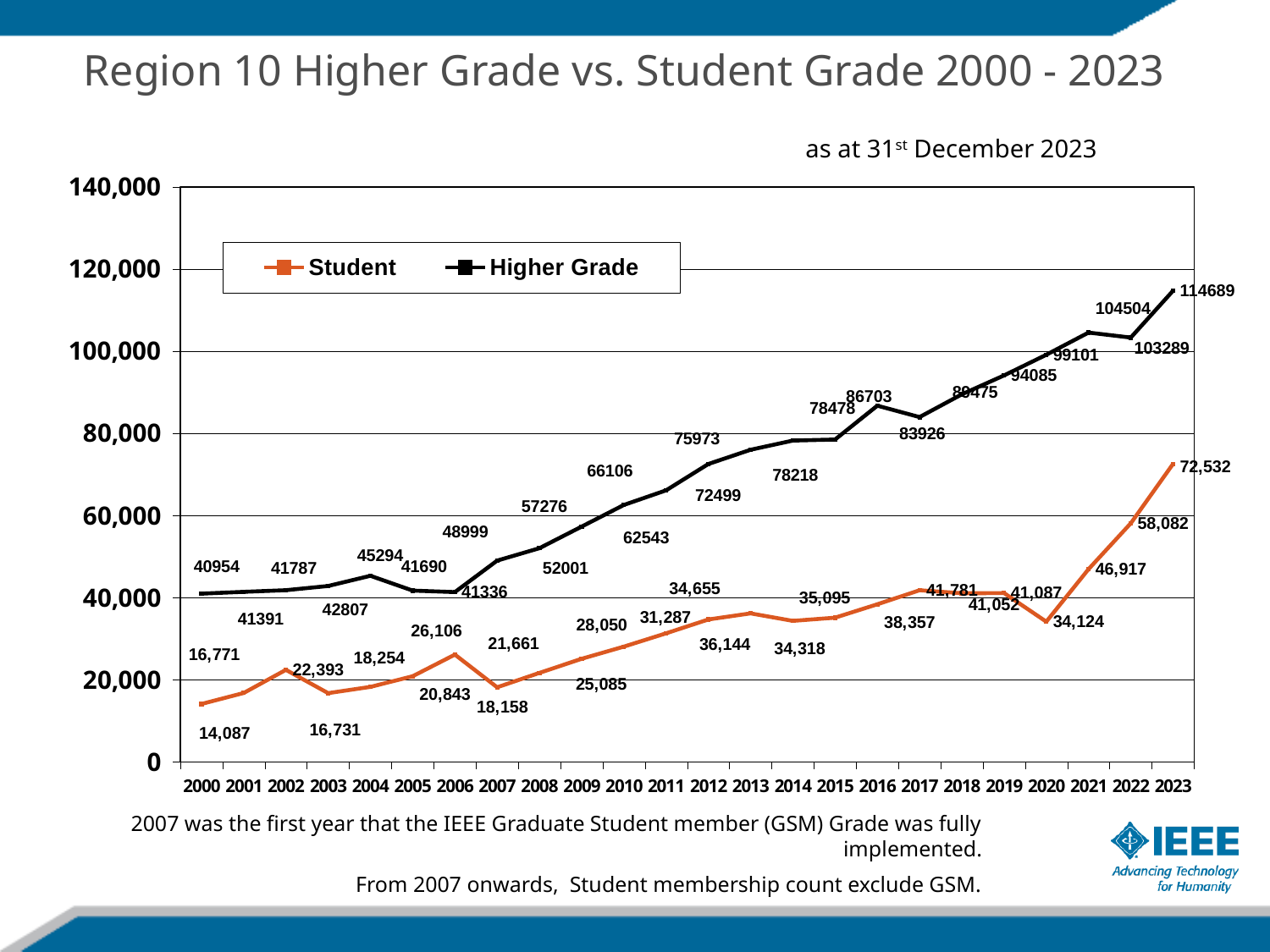
What is the Higher Grade value for 2023? 114689 What is the Student value for 2000? 14,087 What is the Student value for 2023? 72,532 What kind of chart is shown on the slide? line chart Which year has the larger Higher Grade value, 2016 or 2017? 2016 In which year is the Student series at its highest? 2023 By how much did the Student value increase from 2021 to 2022? 11,165 How many series does the legend list? 2 Is the Higher Grade value for 2010 greater or less than 60,000? greater What is the Higher Grade value for 2000? 40954 How many years are plotted on the x axis? 24 In which year is the Student series at its lowest? 2000